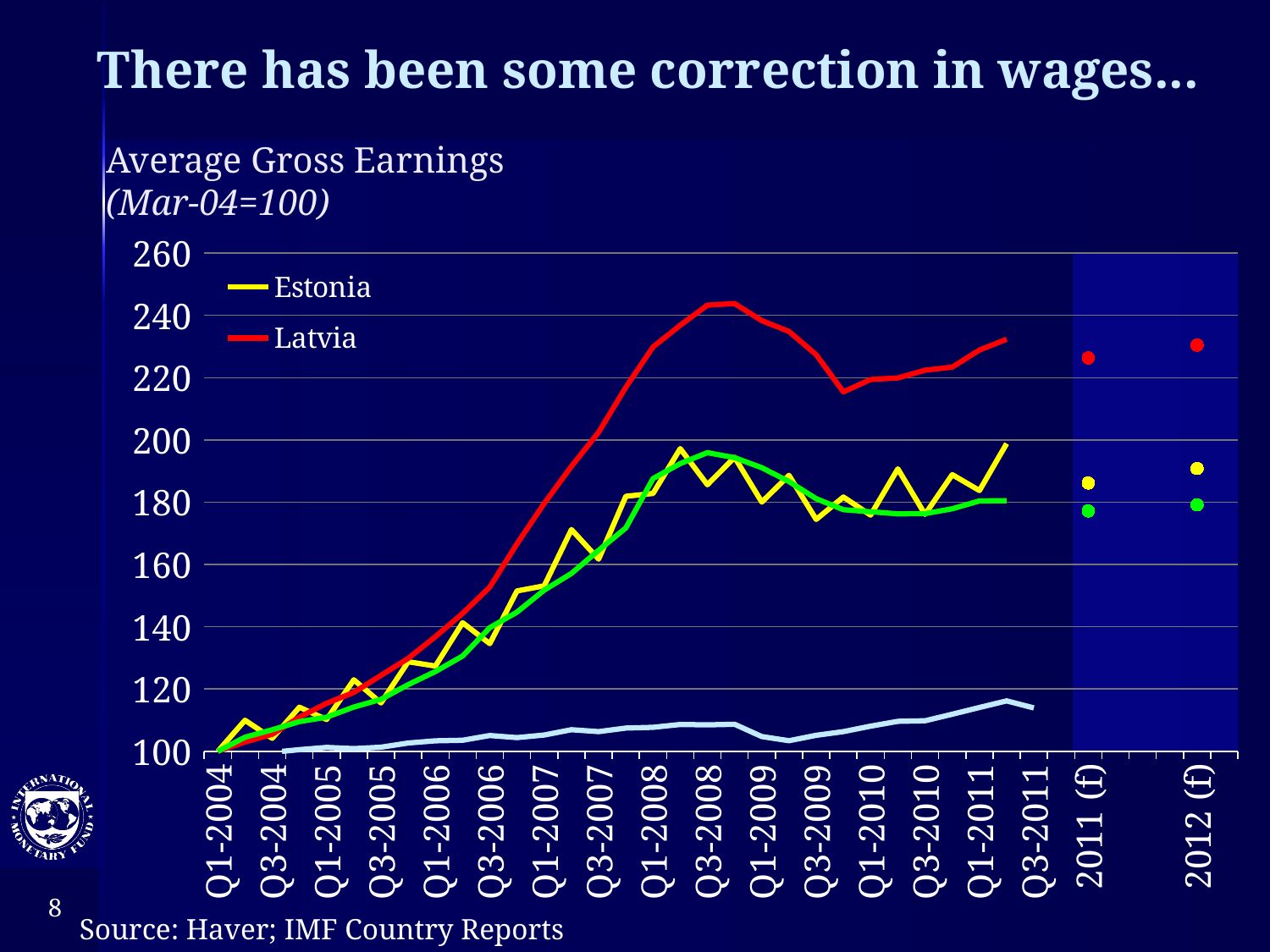
Which series is drawn in red? Latvia At Q3-2008, which is larger, the value for Latvia or the value for Estonia? Latvia Does the value for Latvia rise or fall from Q1-2004 to Q3-2008? rise Which series reaches the highest value on the chart? Latvia Is the value for Latvia at Q1-2007 greater or less than 160? greater Is the value for Latvia at Q3-2009 greater or less than 200? greater What is the value for Estonia at Q1-2004? 100 Is the value for Estonia at Q1-2010 greater or less than 160? greater Which two series are named in the chart's legend? Estonia and Latvia What kind of chart is shown on the slide? line chart How many series does the chart's legend list? 2